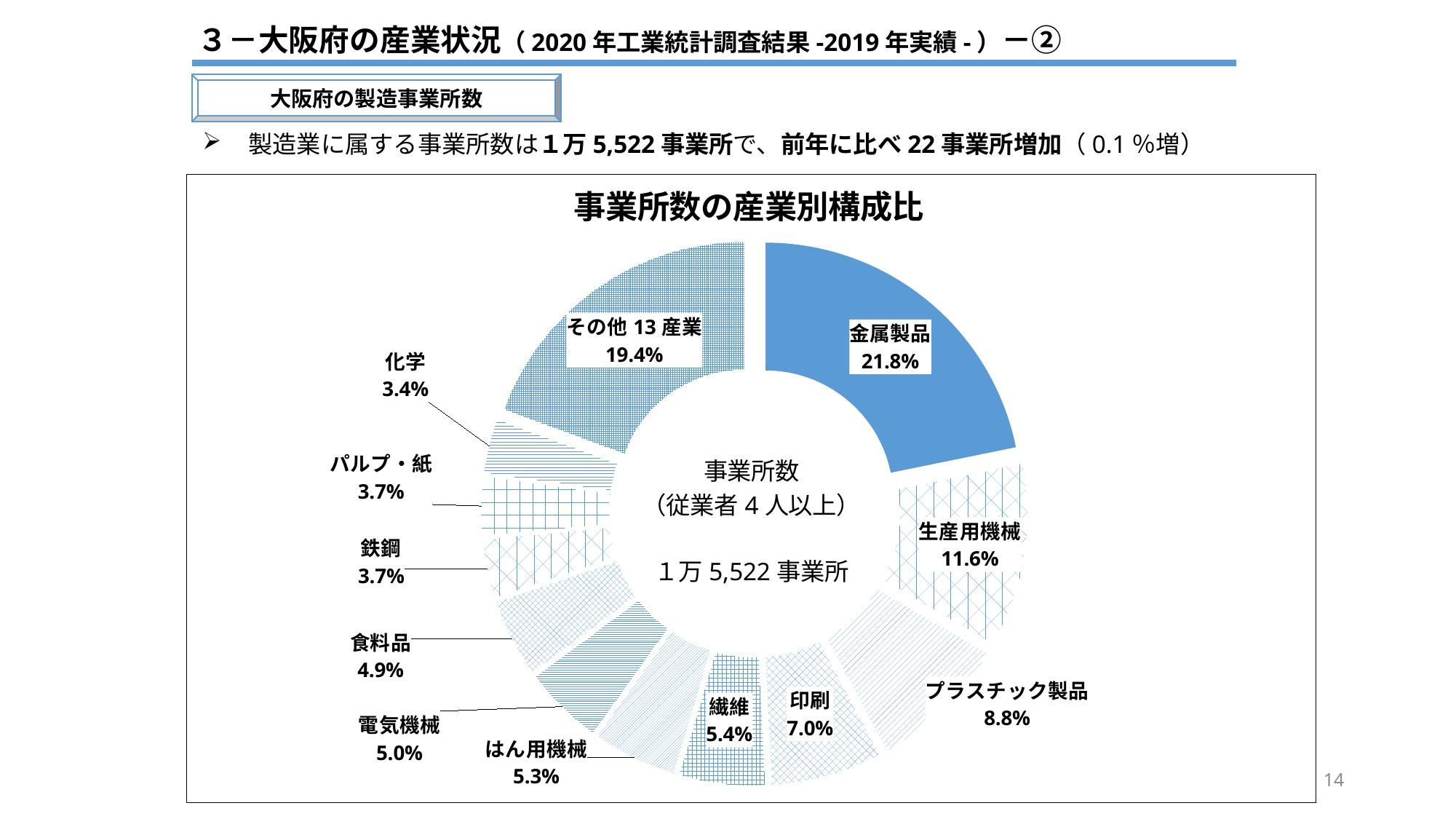
How many categories (segments) are shown in the chart? 12 What share of establishments does 金属製品 account for in the chart? 21.8% Which is larger, the share of 印刷 or the share of 繊維? 印刷 What is the value shown for 生産用機械? 11.6% Which category has the smallest share in the chart? 化学 What is the value for 化学 in the chart? 3.4% What total number of establishments is written in the centre of the chart? 1万5,522事業所 Which single named industry has the largest share in the chart? 金属製品 What is the title of the chart? 事業所数の産業別構成比 What is the difference between the shares of 金属製品 and 生産用機械? 10.2% What percentage is shown for プラスチック製品? 8.8% What kind of chart is shown on the slide? Doughnut (pie) chart